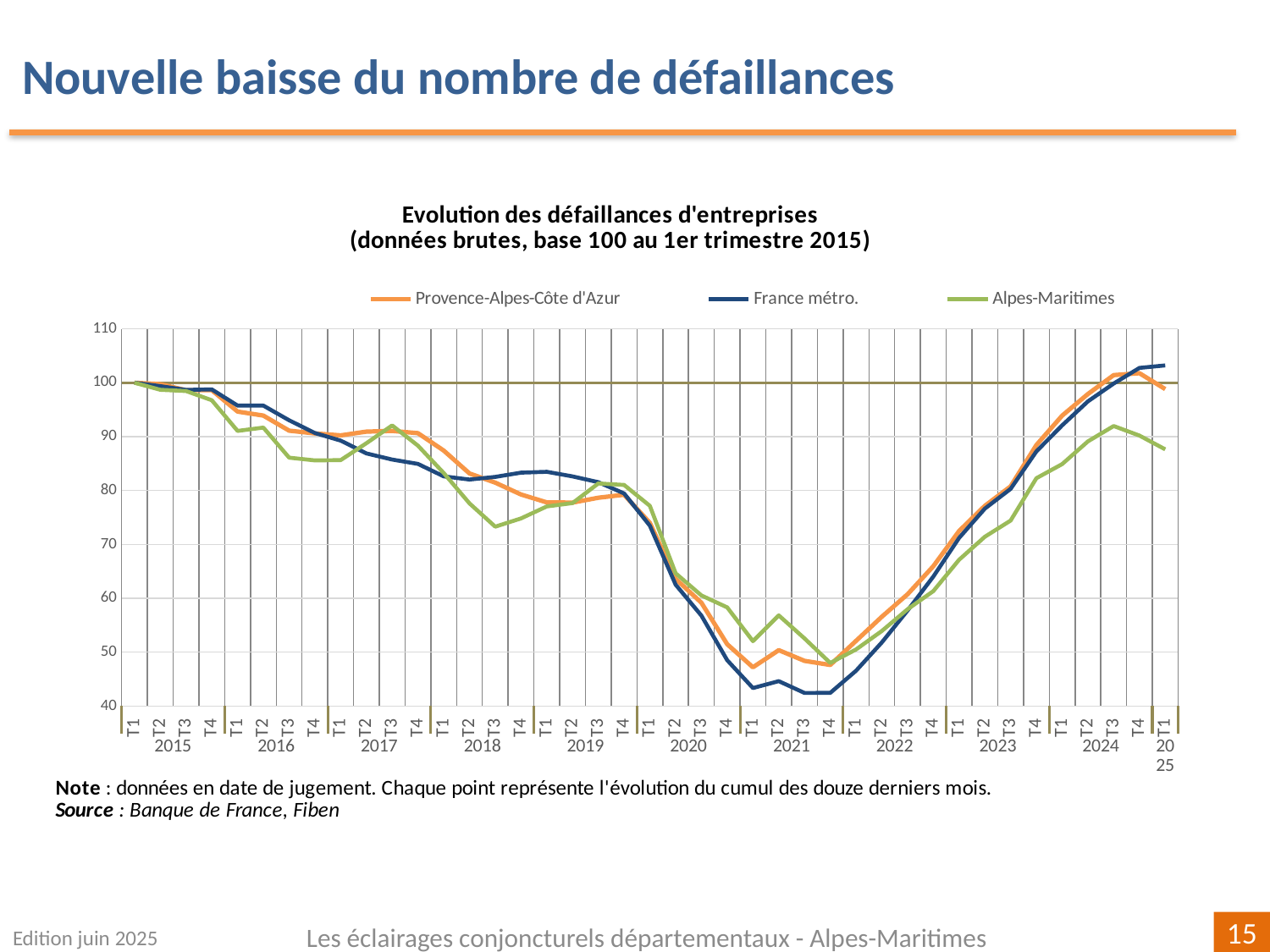
How many years are labelled on the x axis? 11 Do the values for France métro. rise or fall between T1 2020 and T1 2021? fall What is the value of all three series at T1 2015? 100 Is the value for France métro. at T1 2025 greater or less than 100? greater How many series does the legend list? 3 What is the title of the chart? Evolution des défaillances d'entreprises (données brutes, base 100 au 1er trimestre 2015) Is the value for France métro. at T1 2021 greater or less than 50? less At T2 2021, which is higher: Alpes-Maritimes or France métro.? Alpes-Maritimes Is the value for Alpes-Maritimes at T1 2025 greater or less than 90? less At T1 2025, which series has the lowest value? Alpes-Maritimes What kind of chart is shown on the slide? line chart